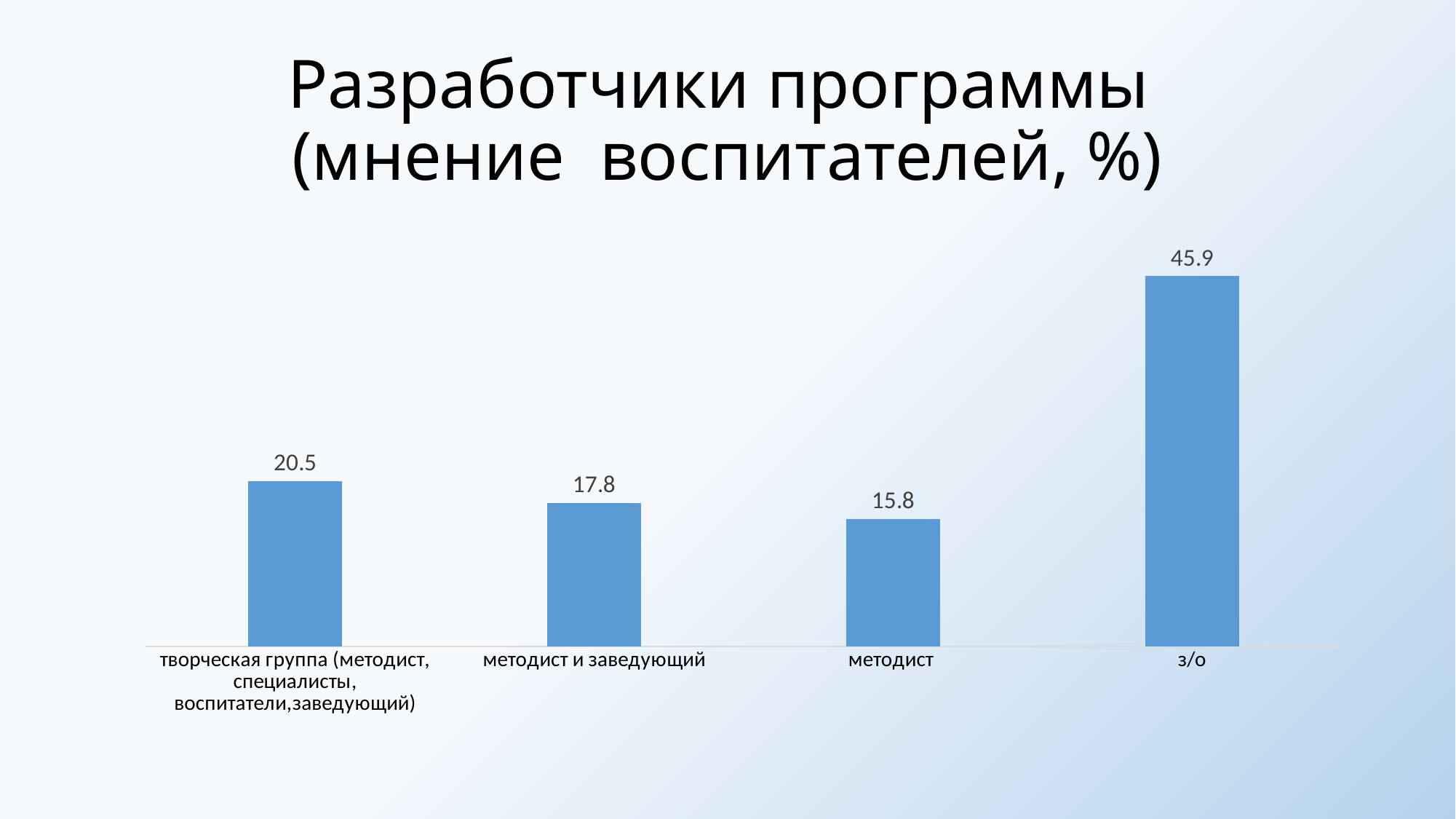
What is the difference between the values for "методист и заведующий" and "методист"? 2.0 Which is larger, the value for "творческая группа" or the value for "методист и заведующий"? творческая группа Which category has the highest value? з/о What is the value for "з/о"? 45.9 What is the value for "творческая группа (методист, специалисты, воспитатели, заведующий)"? 20.5 What is the title of the slide? Разработчики программы (мнение воспитателей, %) What is the value for "методист и заведующий"? 17.8 What is the value for "методист"? 15.8 How many categories are shown in the chart? 4 What is the difference between the values for "з/о" and "творческая группа"? 25.4 What kind of chart is shown on the slide? bar chart Which category has the lowest value? методист